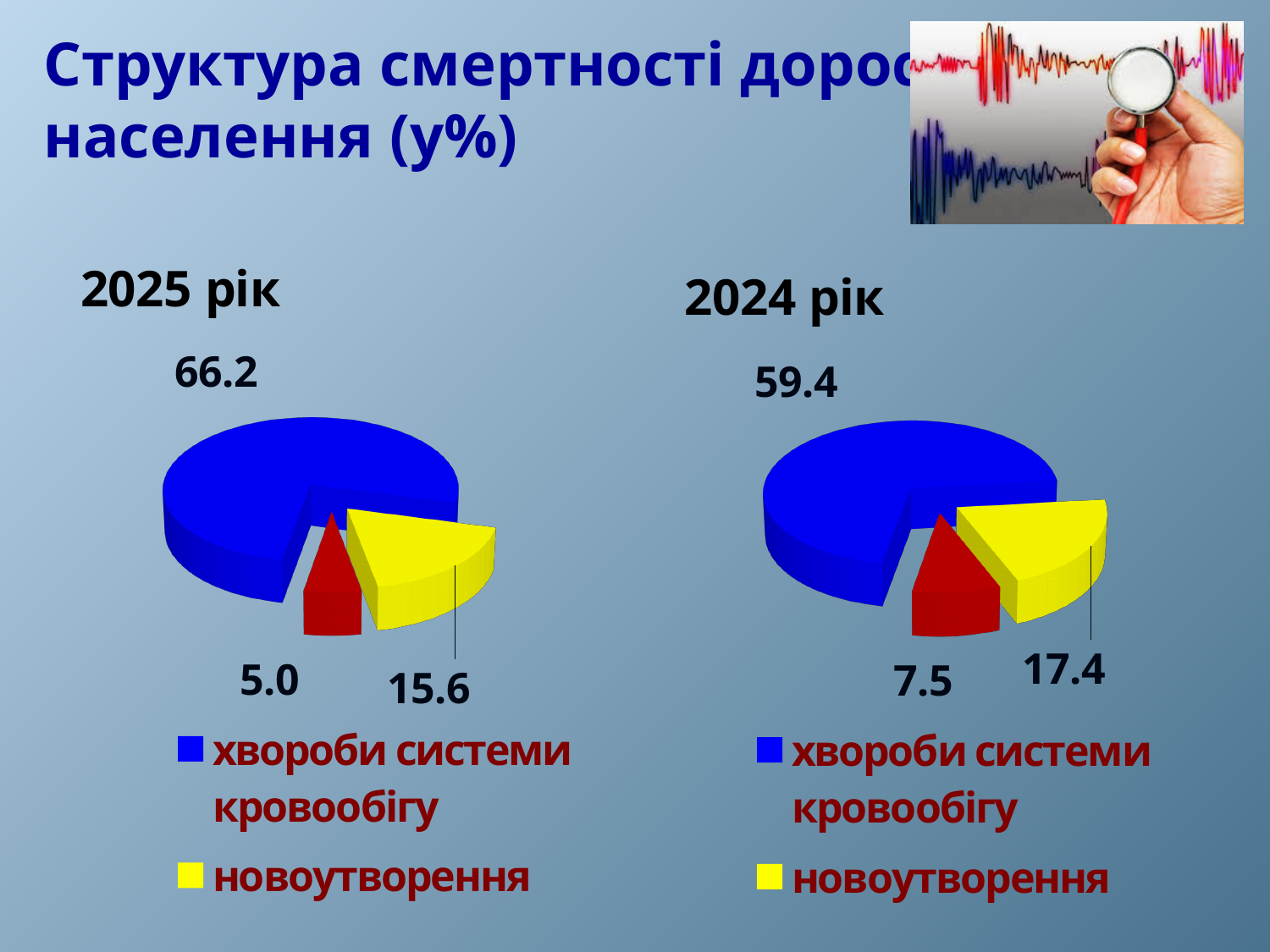
In the 2024 рік chart, what value is shown for новоутворення? 17.4 Which chart shows a larger value for хвороби системи кровообігу, 2025 рік or 2024 рік? 2025 рік In the 2025 рік chart, which legend category has the largest slice? хвороби системи кровообігу How many slices does the 2025 рік pie chart have? 3 In the 2025 рік chart, what value is shown for хвороби системи кровообігу? 66.2 In the 2024 рік chart, what value is shown for хвороби системи кровообігу? 59.4 What type of chart is the 2024 рік chart? pie chart In the 2025 рік chart, what value is shown for новоутворення? 15.6 What is the difference between the хвороби системи кровообігу value in the 2025 рік chart and in the 2024 рік chart? 6.8 How many entries does the legend of the 2024 рік chart list? 2 What is the difference between the новоутворення value in the 2024 рік chart and in the 2025 рік chart? 1.8 In the 2025 рік chart, what colour represents новоутворення? yellow